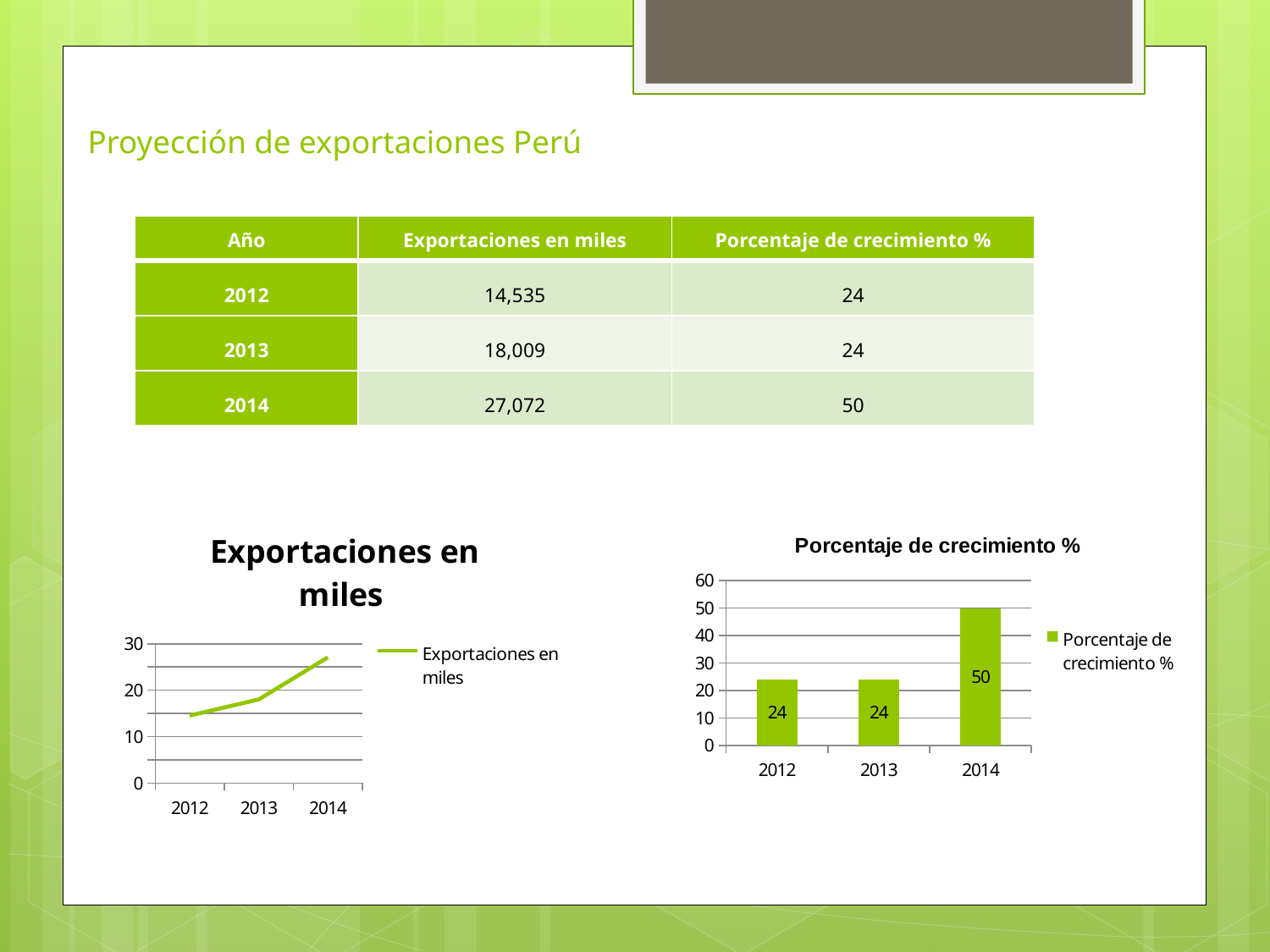
In the 'Porcentaje de crecimiento %' chart, what is the difference between the values for 2014 and 2013? 26 In the 'Porcentaje de crecimiento %' chart, how many bars are plotted? 3 In the 'Porcentaje de crecimiento %' chart, is the value for 2014 larger than the value for 2012? Yes In the 'Porcentaje de crecimiento %' chart, which year has the highest value? 2014 In the 'Exportaciones en miles' chart, do the values rise or fall from 2012 to 2014? Rise How many series does the legend of the 'Exportaciones en miles' chart list? 1 In the 'Exportaciones en miles' chart, is the value for 2012 greater or less than 20? less In the 'Exportaciones en miles' chart, is the value for 2014 greater or less than 20? greater What kind of chart is the 'Porcentaje de crecimiento %' chart? Bar chart In the 'Porcentaje de crecimiento %' chart, what is the value for 2012? 24 In the 'Porcentaje de crecimiento %' chart, what is the value for 2014? 50 What kind of chart is the 'Exportaciones en miles' chart? Line chart